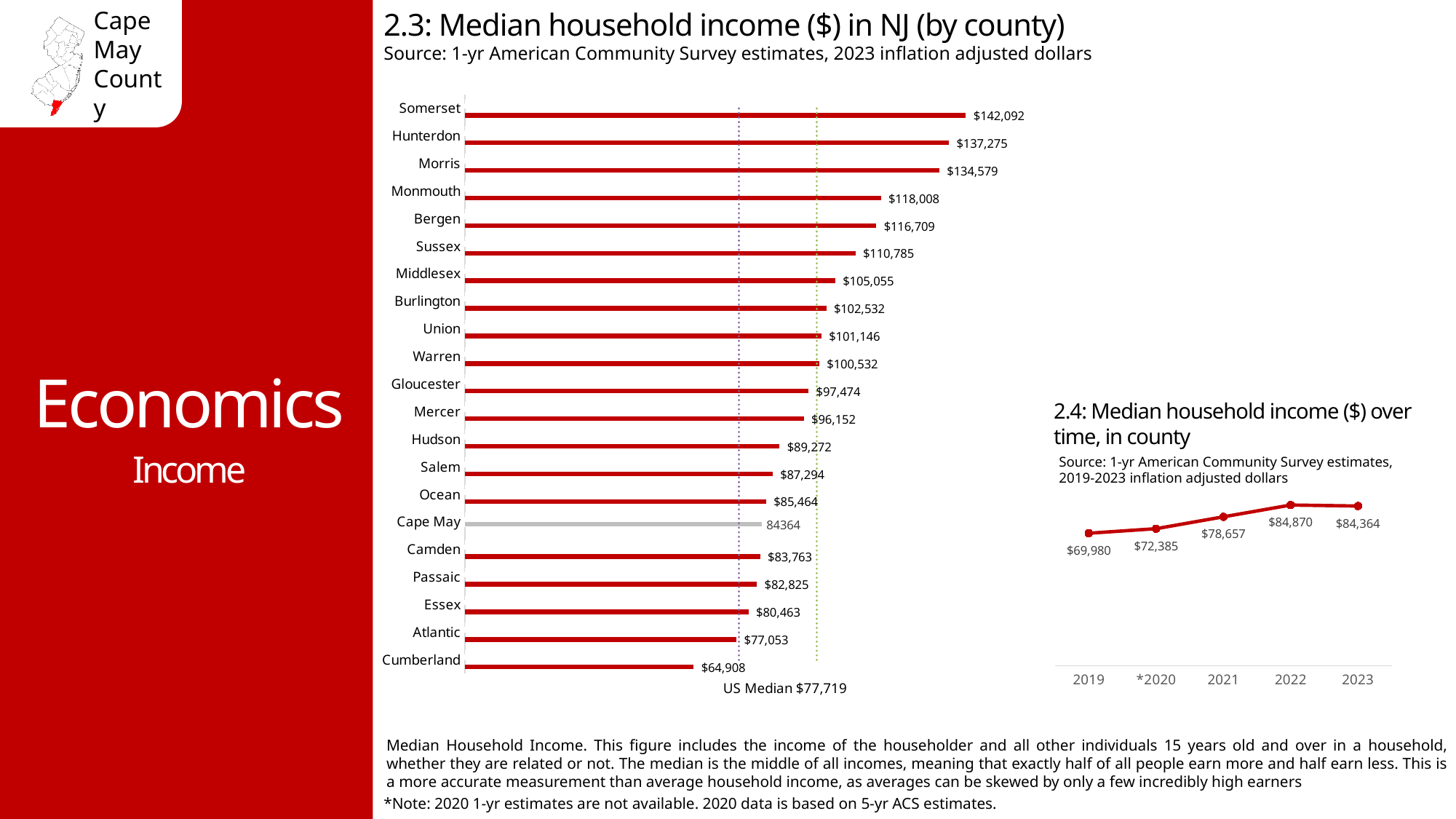
In chart 2.4 (Median household income over time, in county), how many years are plotted? 5 In chart 2.4 (Median household income over time, in county), what is the median household income for 2021? $78,657 In chart 2.4 (Median household income over time, in county), which year has the highest median household income? 2022 In chart 2.3 (Median household income by county), which county has the lowest median household income? Cumberland In chart 2.3 (Median household income by county), what value is shown for Cape May? 84364 In chart 2.3 (Median household income by county), what is the difference between Somerset's and Cumberland's median household income? $77,184 In chart 2.3 (Median household income by county), how many counties are plotted? 21 In chart 2.3 (Median household income by county), what is the median household income for Somerset? $142,092 In chart 2.3 (Median household income by county), which county has the highest median household income? Somerset What kind of chart is chart 2.3 (Median household income by county)? Bar chart In chart 2.4 (Median household income over time, in county), what is the difference between the 2022 and 2023 values? $506 In chart 2.3 (Median household income by county), which has a higher median household income, Hudson or Salem? Hudson